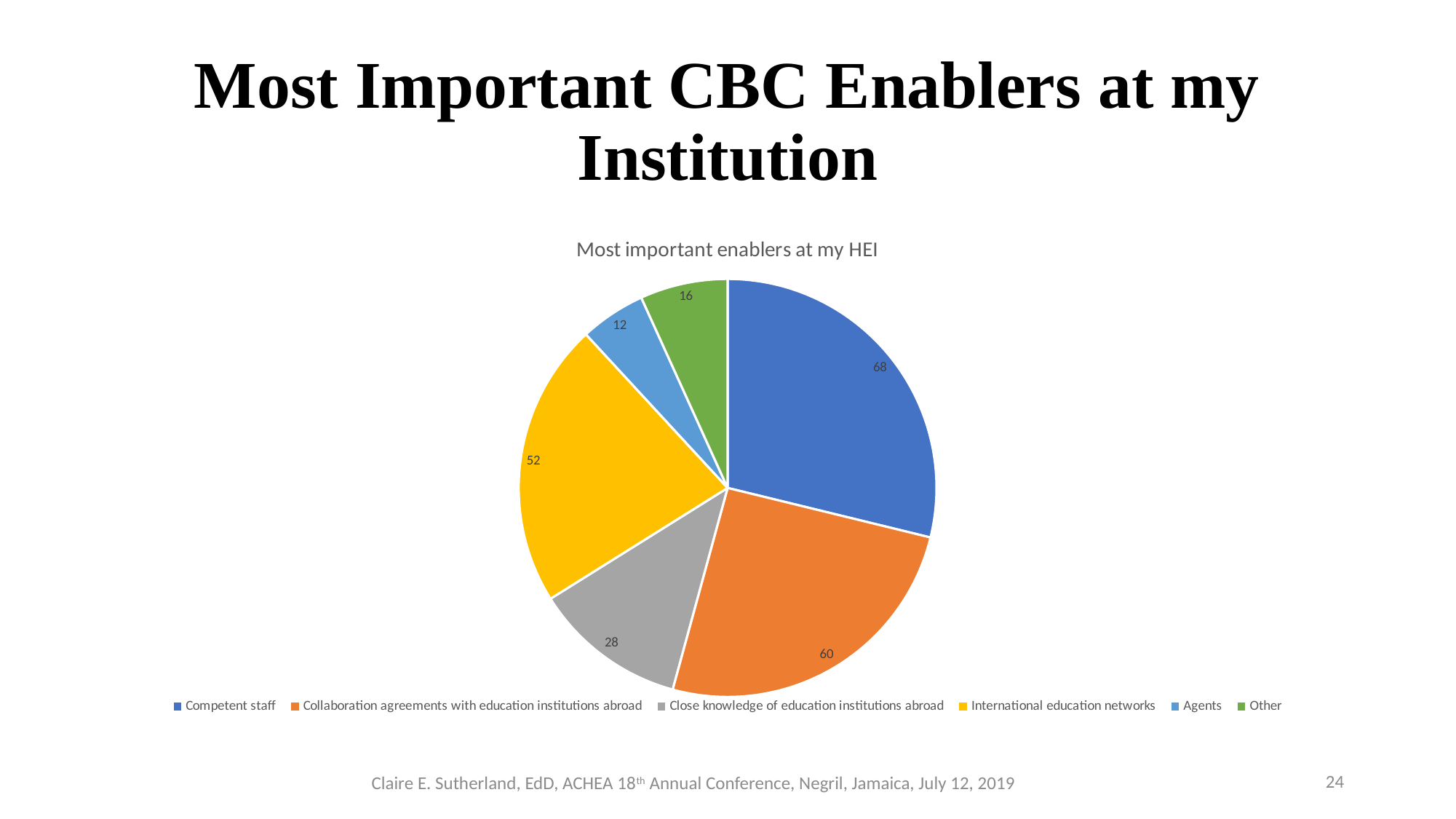
What type of chart is shown on the slide? Pie chart Which is larger, the value for International education networks or the value for Collaboration agreements with education institutions abroad? Collaboration agreements with education institutions abroad Which category has the smallest slice of the pie? Agents How many categories does the pie chart show? 6 What is the value for Agents? 12 What is the total of all the slices in the pie chart? 236 What is the value for Competent staff? 68 Which category has the largest slice of the pie? Competent staff What is the title shown above the pie chart? Most important enablers at my HEI What is the value for Collaboration agreements with education institutions abroad? 60 What is the difference between the values for Competent staff and Close knowledge of education institutions abroad? 40 What is the value for International education networks? 52